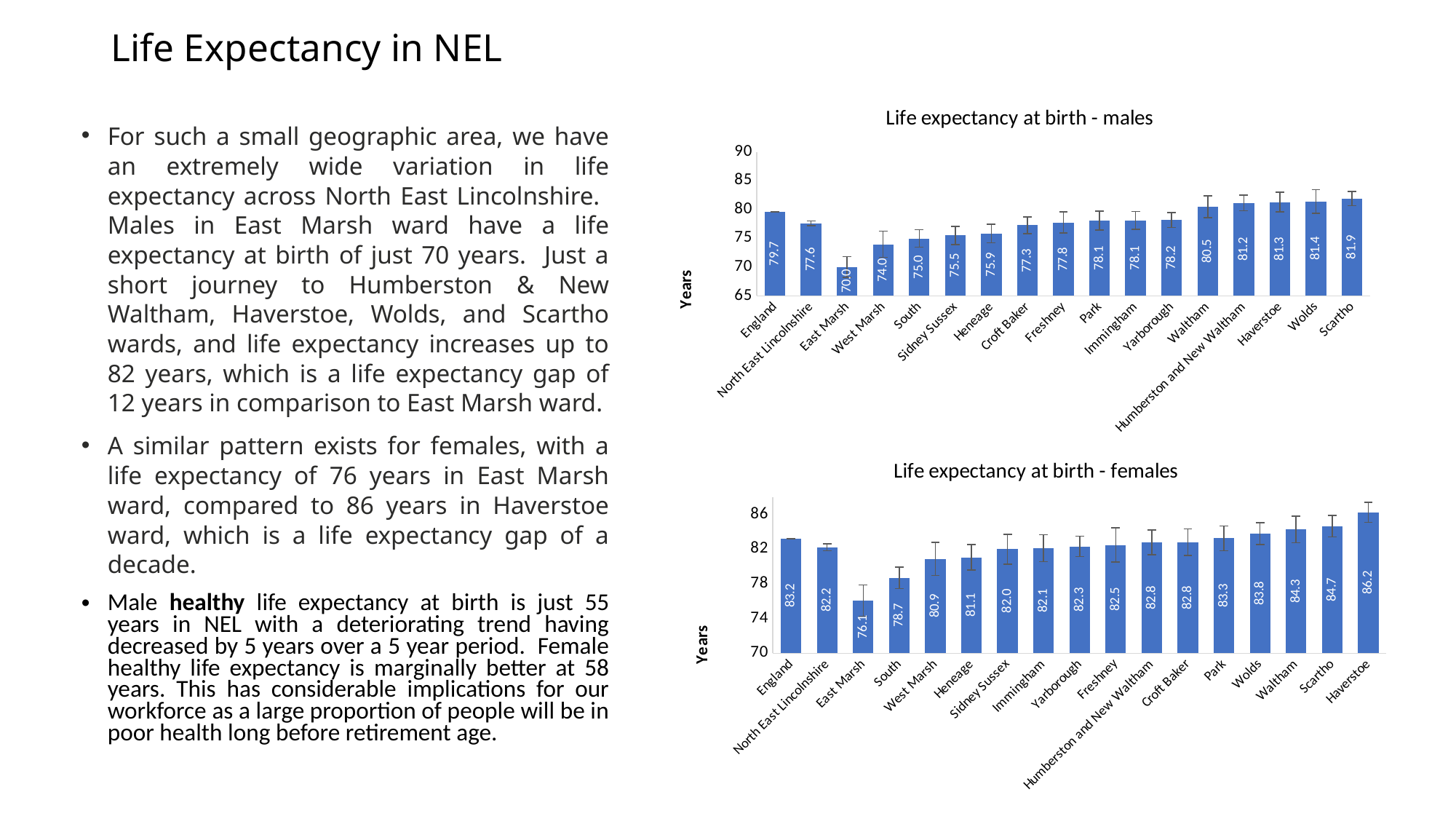
In the 'Life expectancy at birth - males' chart, how many bars are plotted? 17 In the 'Life expectancy at birth - females' chart, what is the value for North East Lincolnshire? 82.2 What type of chart is 'Life expectancy at birth - males'? Bar chart In the 'Life expectancy at birth - males' chart, which area has the highest life expectancy? Scartho In the 'Life expectancy at birth - males' chart, what is the value for England? 79.7 What is the y-axis label on the 'Life expectancy at birth - females' chart? Years In the 'Life expectancy at birth - females' chart, what is the difference between Haverstoe and East Marsh? 10.1 In the 'Life expectancy at birth - males' chart, what is the value for East Marsh? 70.0 In the 'Life expectancy at birth - females' chart, which area has the lowest life expectancy? East Marsh In the 'Life expectancy at birth - females' chart, what is the value for Haverstoe? 86.2 In the 'Life expectancy at birth - males' chart, what is the difference between Scartho and East Marsh? 11.9 In the 'Life expectancy at birth - females' chart, which is larger, the value for Wolds or the value for South? Wolds